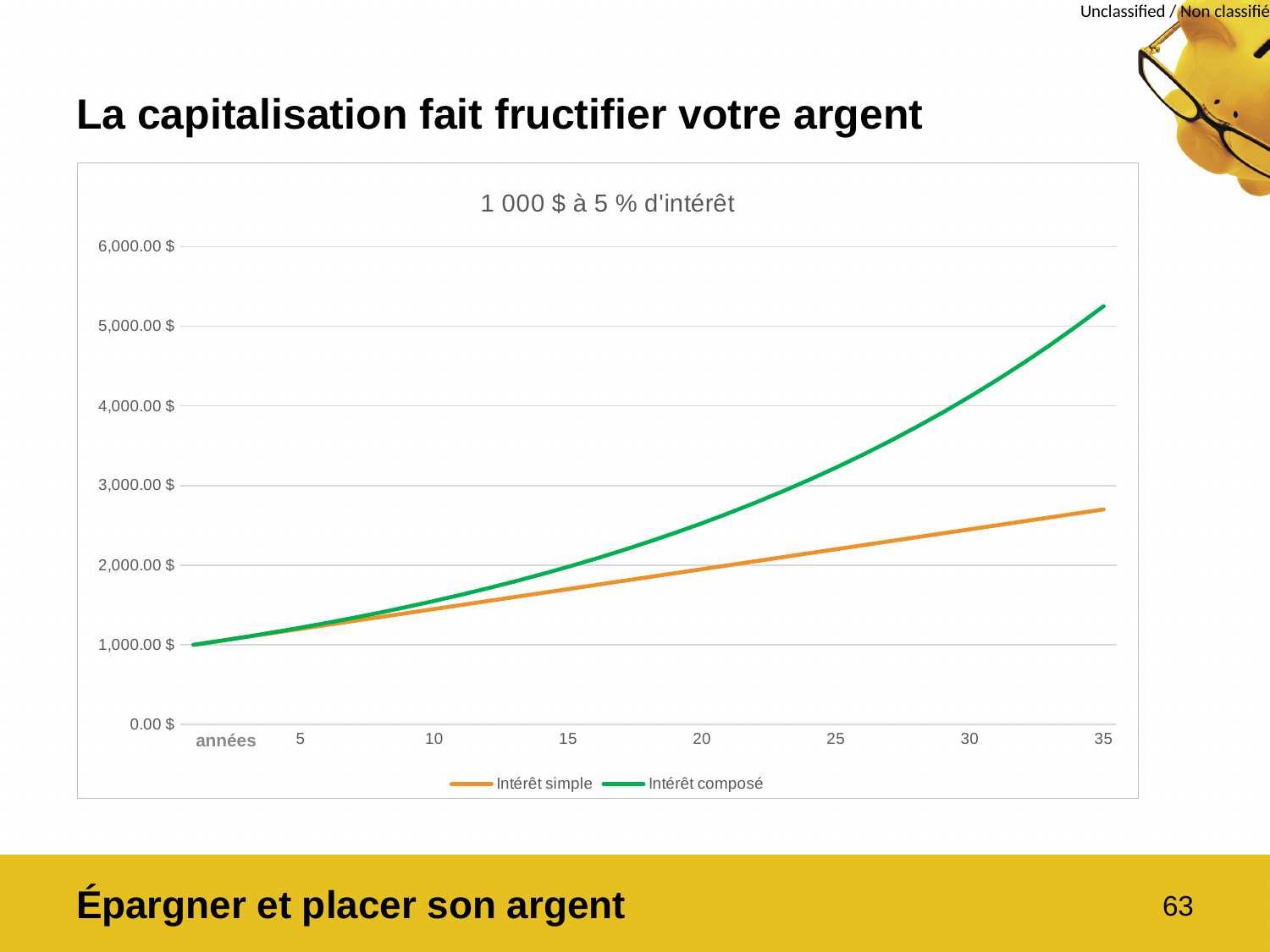
At what value do both lines start at the left of the chart? 1,000.00 $ Is the value of Intérêt composé at 20 years greater or less than 2,000.00 $? greater How many series does the chart's legend list? 2 Which colour is used for the Intérêt composé line? green What is the title of the chart? 1 000 $ à 5 % d'intérêt At 35 years, which series has the larger value, Intérêt simple or Intérêt composé? Intérêt composé Which series reaches the highest value on the chart? Intérêt composé Is the value of Intérêt composé at 35 years greater or less than 5,000.00 $? greater Is the value of Intérêt composé at 30 years greater or less than 4,000.00 $? greater Do the values of the Intérêt composé series rise or fall as the years increase? rise What kind of chart is shown on the slide? line chart